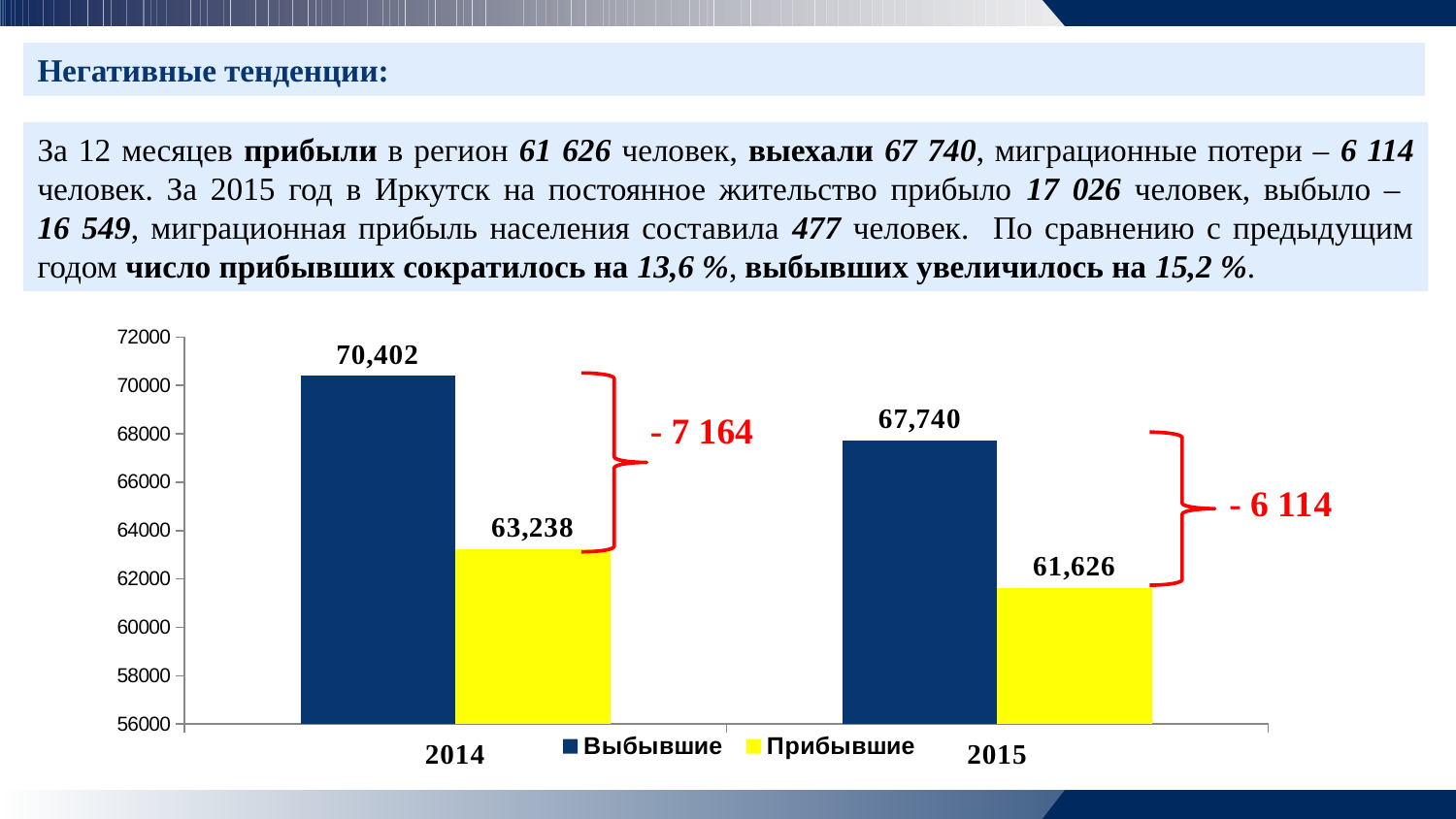
Which year has the highest value for Выбывшие? 2014 What is the value for Прибывшие in 2014? 63,238 What kind of chart is shown on the slide? Bar chart What is the value for Выбывшие in 2014? 70,402 What is the difference between Выбывшие and Прибывшие in 2014? 7,164 What is the value for Выбывшие in 2015? 67,740 Which bar has the lowest value on the chart? Прибывшие in 2015 Which is larger: Прибывшие in 2014 or Выбывшие in 2015? Выбывшие in 2015 How many series does the legend list? 2 What is the difference between Выбывшие and Прибывшие in 2015? 6,114 What is the value for Прибывшие in 2015? 61,626 Do the values for Прибывшие rise or fall from 2014 to 2015? Fall